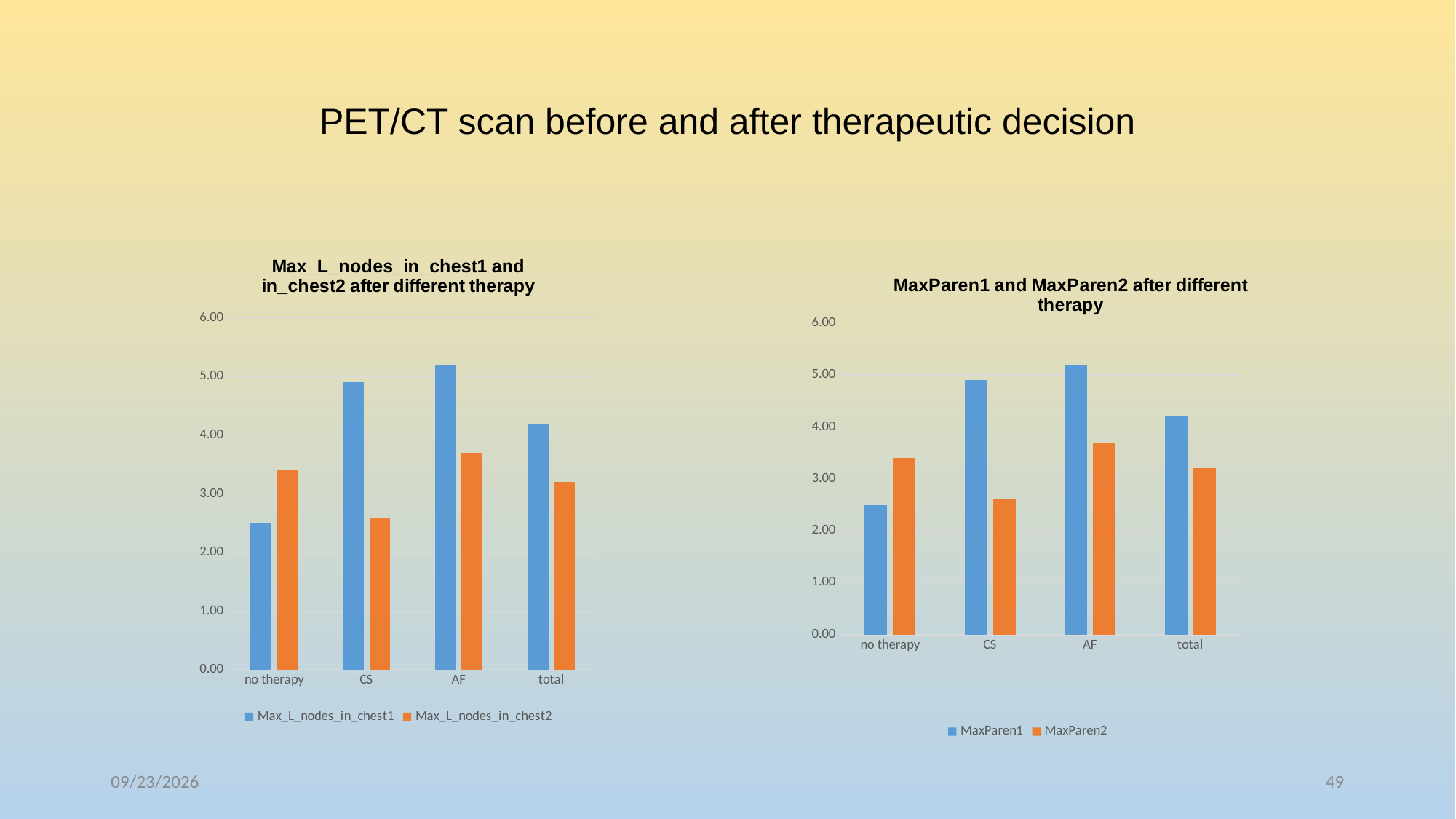
In the left chart (Max_L_nodes_in_chest1 and in_chest2), which category has the highest Max_L_nodes_in_chest1 value? AF In the right chart (MaxParen1 and MaxParen2 after different therapy), for the CS category, which series has the larger value? MaxParen1 In the right chart (MaxParen1 and MaxParen2 after different therapy), which category has the highest MaxParen1 value? AF What kind of chart is the left chart titled "Max_L_nodes_in_chest1 and in_chest2 after different therapy"? bar chart In the right chart (MaxParen1 and MaxParen2 after different therapy), what are the two legend entries? MaxParen1 and MaxParen2 In the left chart (Max_L_nodes_in_chest1 and in_chest2), is the Max_L_nodes_in_chest1 value for CS greater or less than 4.00? greater In the right chart (MaxParen1 and MaxParen2 after different therapy), which category has the lowest MaxParen2 value? CS In the left chart (Max_L_nodes_in_chest1 and in_chest2), how many therapy categories are shown on the x axis? 4 In the left chart (Max_L_nodes_in_chest1 and in_chest2), for the "no therapy" category, which series has the larger value? Max_L_nodes_in_chest2 In the left chart (Max_L_nodes_in_chest1 and in_chest2), how many series does the legend list? 2 In the right chart (MaxParen1 and MaxParen2 after different therapy), is the MaxParen2 value for AF greater or less than 3.00? greater In the left chart (Max_L_nodes_in_chest1 and in_chest2), which category has the lowest Max_L_nodes_in_chest1 value? no therapy